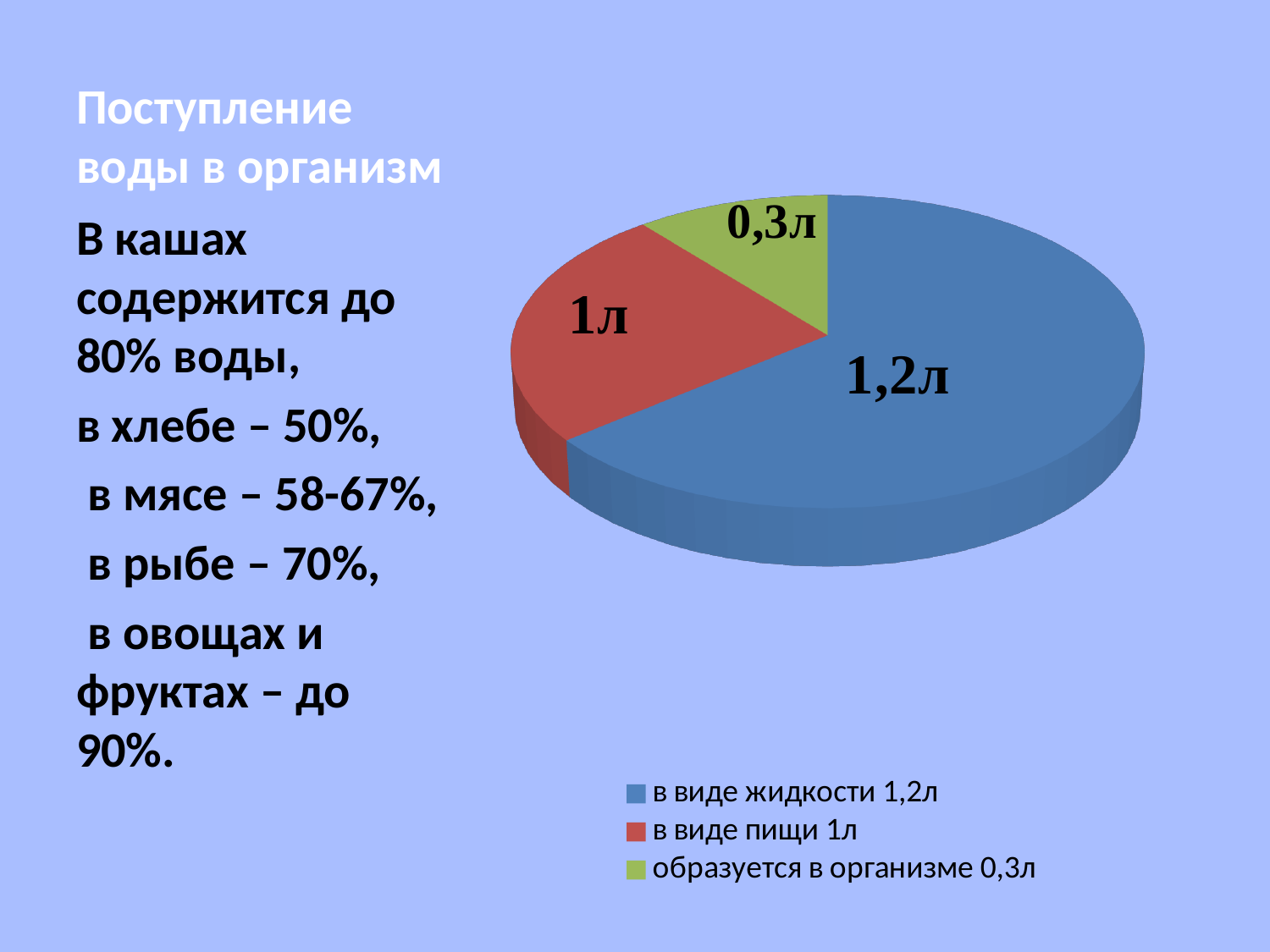
What value is shown for the slice 'в виде пищи'? 1л What value is shown for the slice 'в виде жидкости'? 1,2л Which slice of the pie chart is the largest? в виде жидкости 1,2л What value is shown for the slice 'образуется в организме'? 0,3л How many slices does the pie chart have? 3 How many entries does the legend of the pie chart list? 3 Which is larger: the value for 'в виде пищи' or the value for 'образуется в организме'? в виде пищи What kind of chart is shown on the slide? Pie chart What colour is the slice for 'в виде пищи 1л'? Red What is the difference between the 'в виде жидкости' value and the 'в виде пищи' value? 0,2л Which slice of the pie chart is the smallest? образуется в организме 0,3л